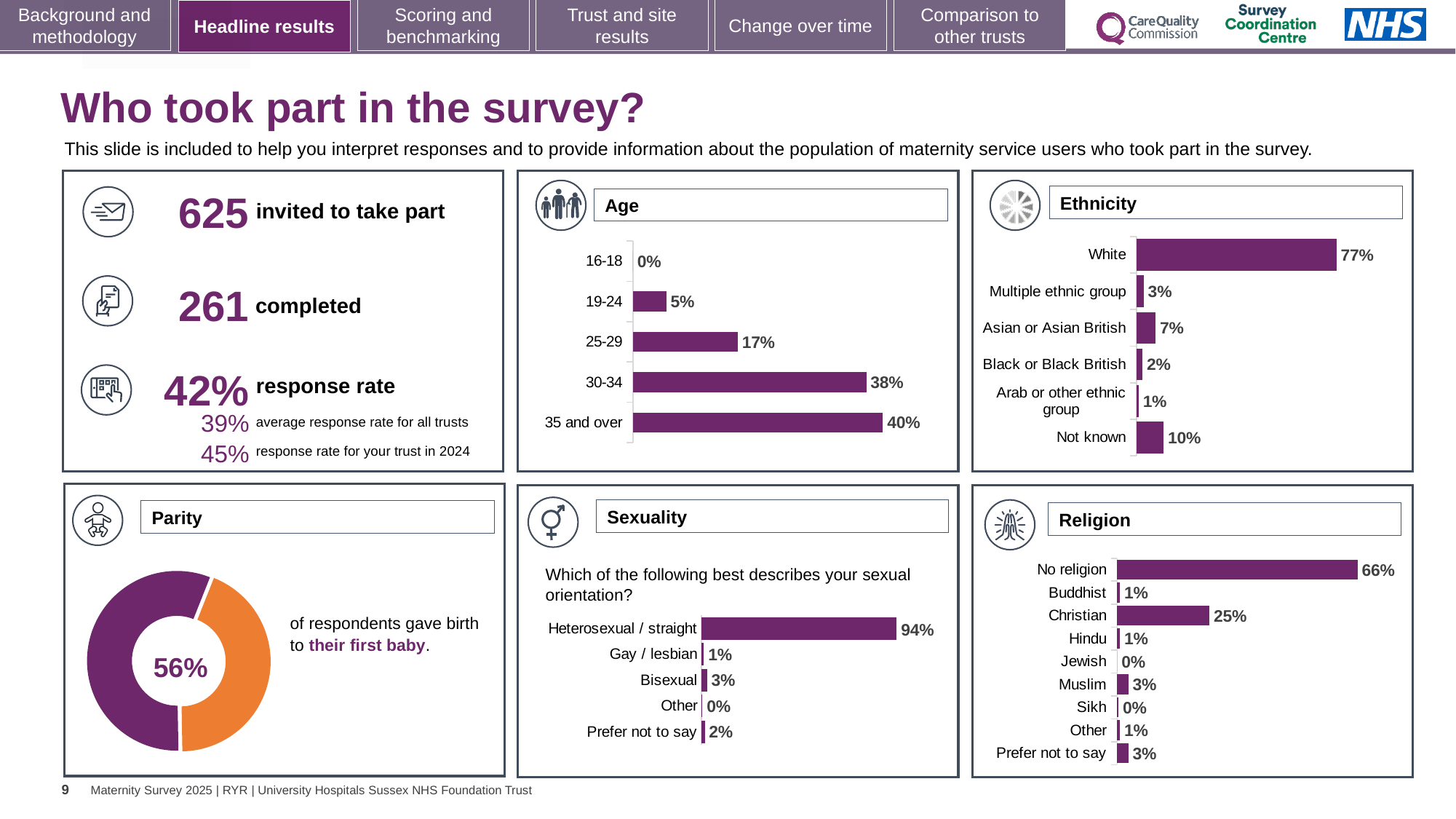
What kind of chart is the Parity chart? Doughnut chart In the Religion chart, what percentage of respondents were Christian? 25% In the Age chart, what percentage of respondents were aged 30-34? 38% In the Ethnicity chart, what percentage of respondents were White? 77% In the Parity chart, what share of respondents gave birth to their first baby? 56% In the Age chart, what is the difference between the 35 and over group and the 25-29 group? 23% In the Religion chart, how many categories are shown? 9 In the Age chart, which age group has the highest percentage? 35 and over In the Ethnicity chart, which category has the lowest percentage? Arab or other ethnic group In the Ethnicity chart, how many categories are shown? 6 In the Sexuality chart, what percentage of respondents answered Bisexual? 3% In the Religion chart, which is larger, Muslim or Hindu? Muslim